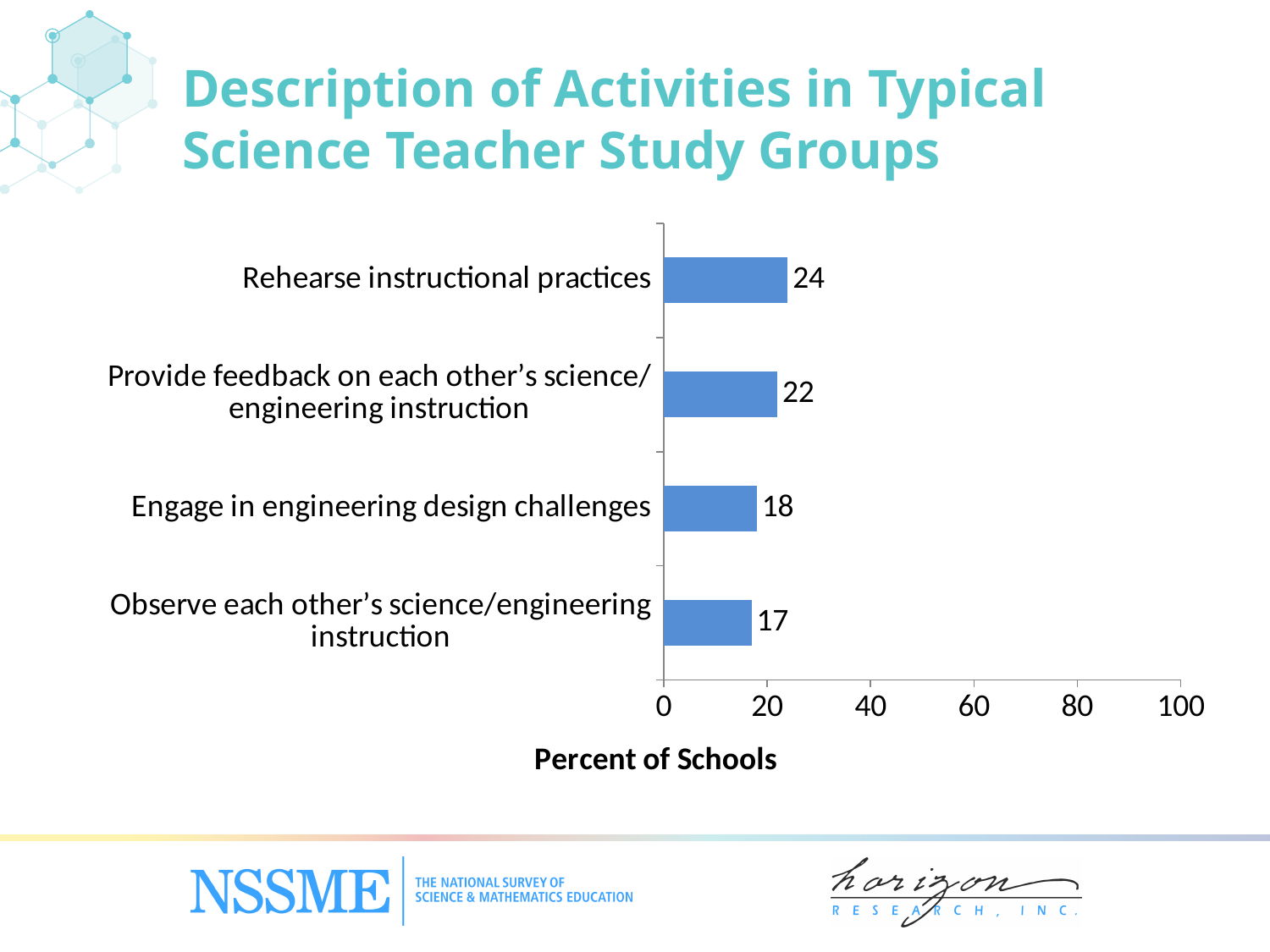
Is the value for 'Rehearse instructional practices' greater or less than 40? less What is the value for 'Provide feedback on each other's science/engineering instruction'? 22 What is the value for 'Observe each other's science/engineering instruction'? 17 Which is larger: the value for 'Provide feedback on each other's science/engineering instruction' or 'Engage in engineering design challenges'? Provide feedback on each other's science/engineering instruction What is the label of the horizontal axis? Percent of Schools Which activity has the lowest percent of schools? Observe each other's science/engineering instruction What percent of schools report that teachers rehearse instructional practices in typical science teacher study groups? 24 What kind of chart is shown on the slide? Bar chart What is the value for 'Engage in engineering design challenges'? 18 How many activities are shown in the chart? 4 Which activity has the highest percent of schools? Rehearse instructional practices What is the difference between the values for 'Rehearse instructional practices' and 'Observe each other's science/engineering instruction'? 7